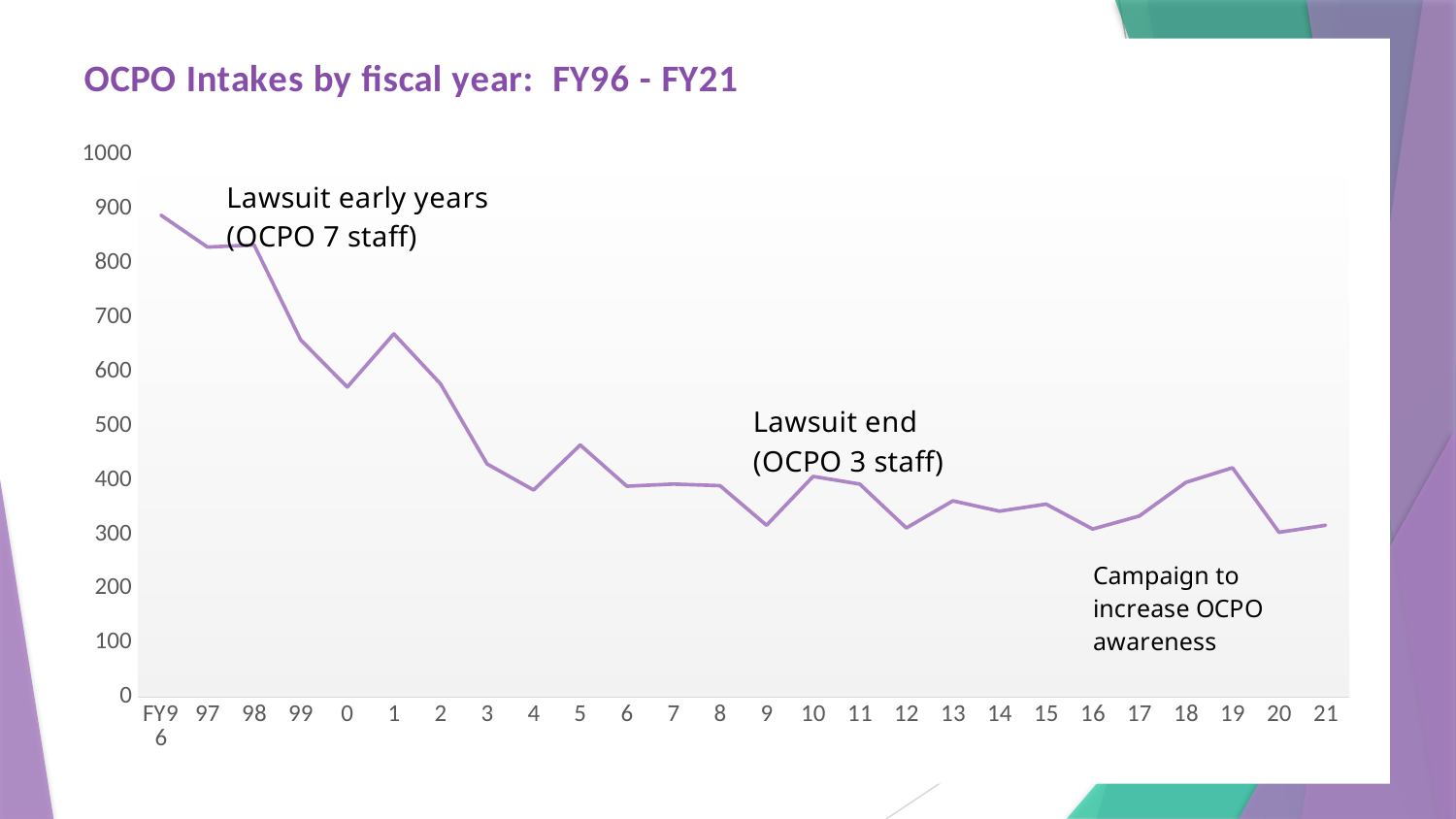
According to the annotation, how many OCPO staff were there in the lawsuit early years? 7 staff Is the value for fiscal year 20 greater or less than 400? less Do the intake values generally rise or fall from FY96 to FY21? Fall Which fiscal year has the highest number of intakes? FY96 Is the value for fiscal year 9 greater or less than 400? less Is the value for fiscal year 1 greater or less than 600? greater How many fiscal years are plotted on the x axis? 26 What is the title of the chart? OCPO Intakes by fiscal year: FY96 - FY21 Which is larger, the value for FY96 or the value for fiscal year 21? FY96 What kind of chart is shown on the slide? Line chart